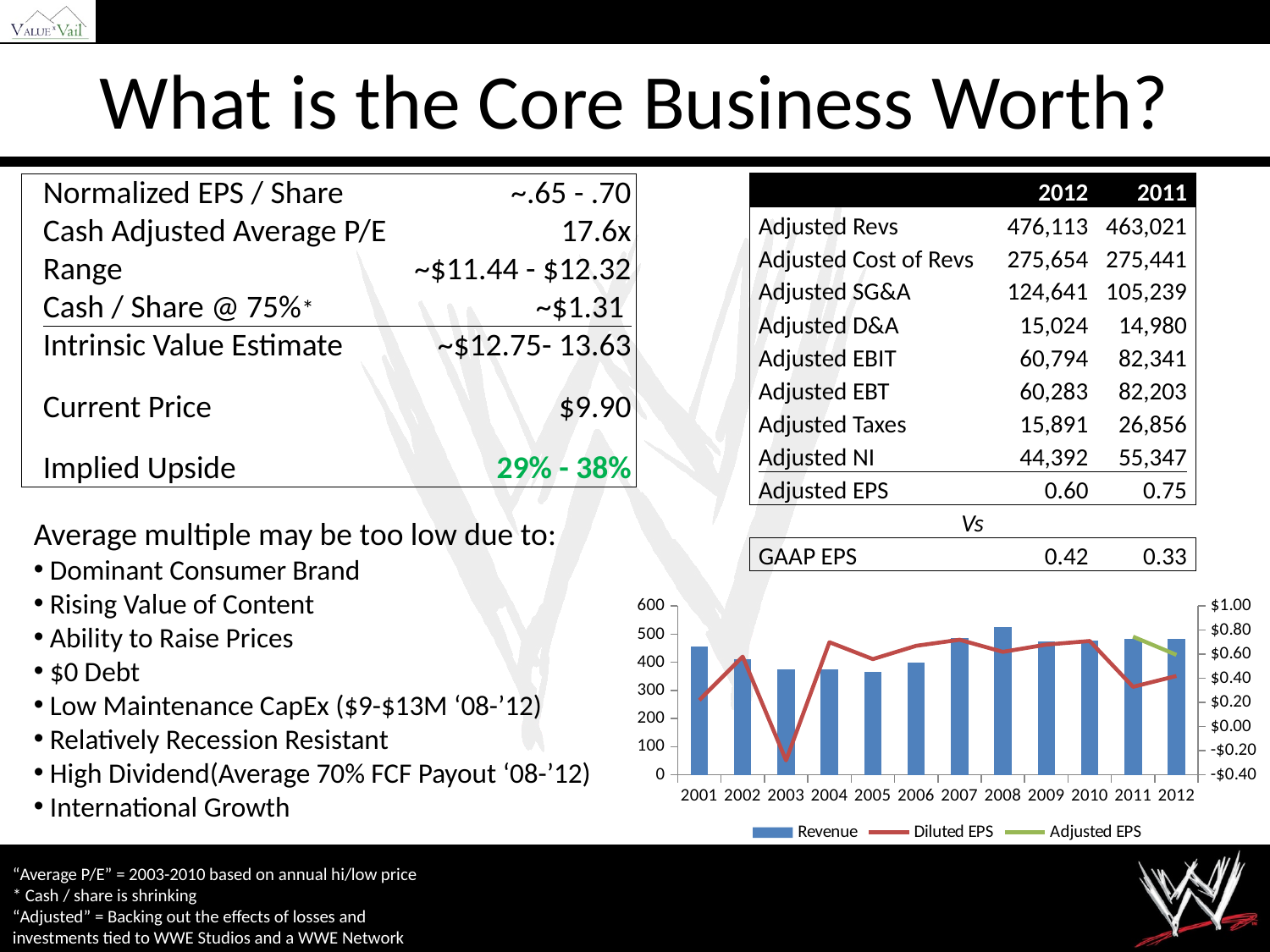
Which year has the larger Revenue bar, 2001 or 2003? 2001 Does the Diluted EPS line rise or fall from 2010 to 2011? Fall How many series does the chart legend list? 3 How many years are shown on the x axis of the chart? 12 Is the Diluted EPS value for 2003 greater or less than $0.00? less What are the three entries in the chart legend? Revenue, Diluted EPS, Adjusted EPS Is the Diluted EPS value for 2007 greater or less than $0.60? greater Which year has the highest Revenue bar? 2008 Which year has the lowest Diluted EPS value? 2003 Is the Revenue value for 2008 greater or less than 500? greater Is the Revenue series drawn as bars or as a line? Bars